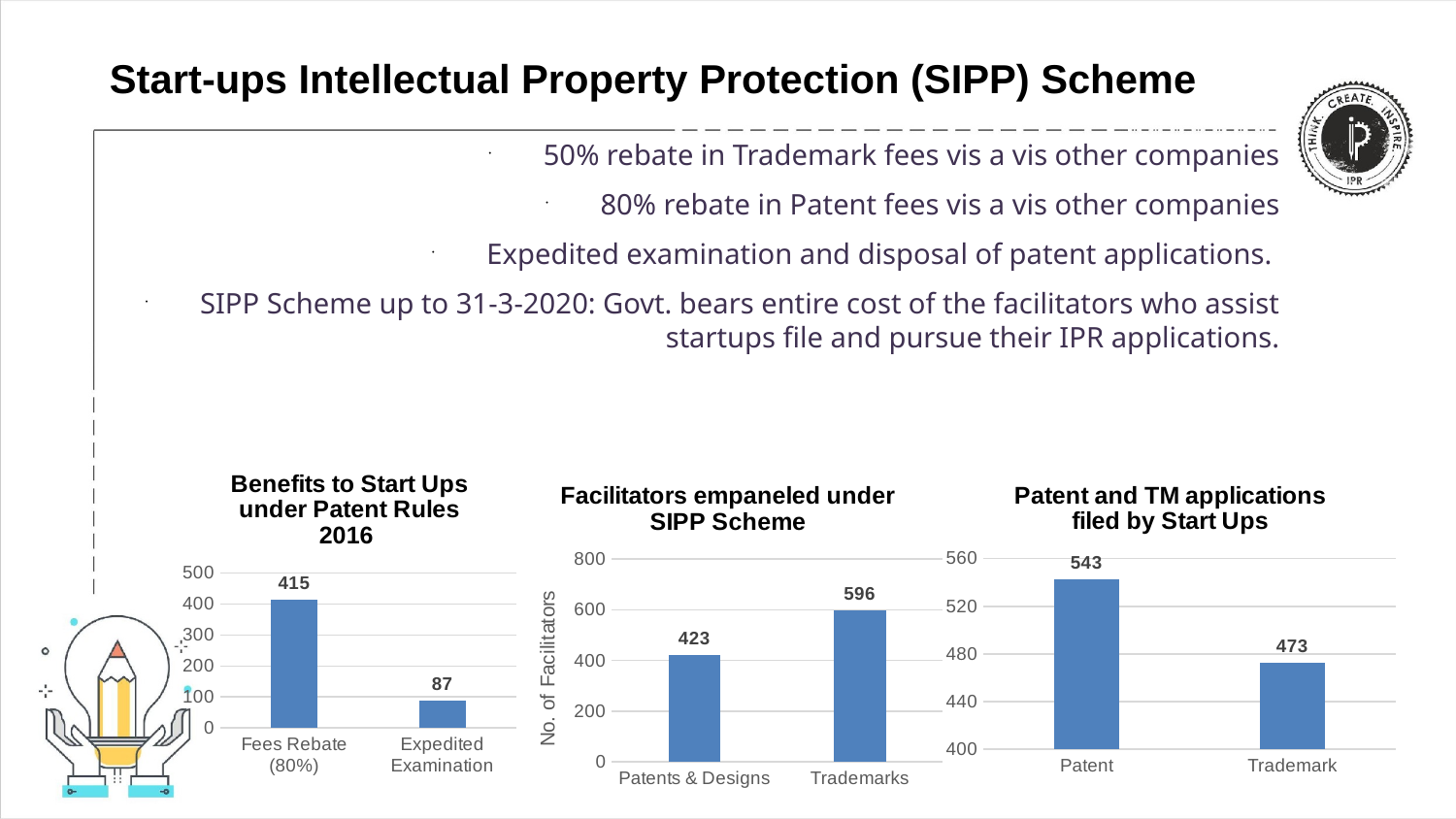
What type of chart is the 'Facilitators empaneled under SIPP Scheme' chart? Bar chart In the 'Facilitators empaneled under SIPP Scheme' chart, what is the difference between Trademarks and Patents & Designs? 173 In the 'Patent and TM applications filed by Start Ups' chart, what is the value for Trademark? 473 In the 'Benefits to Start Ups under Patent Rules 2016' chart, what is the difference between Fees Rebate (80%) and Expedited Examination? 328 In the 'Patent and TM applications filed by Start Ups' chart, which category has the lowest value? Trademark In the 'Benefits to Start Ups under Patent Rules 2016' chart, what is the value for Expedited Examination? 87 In the 'Facilitators empaneled under SIPP Scheme' chart, what is the value for Trademarks? 596 In the 'Patent and TM applications filed by Start Ups' chart, what is the difference between Patent and Trademark? 70 In the 'Patent and TM applications filed by Start Ups' chart, what is the value for Patent? 543 In the 'Facilitators empaneled under SIPP Scheme' chart, which category has the highest value? Trademarks In the 'Benefits to Start Ups under Patent Rules 2016' chart, what is the value for Fees Rebate (80%)? 415 In the 'Facilitators empaneled under SIPP Scheme' chart, what is the value for Patents & Designs? 423